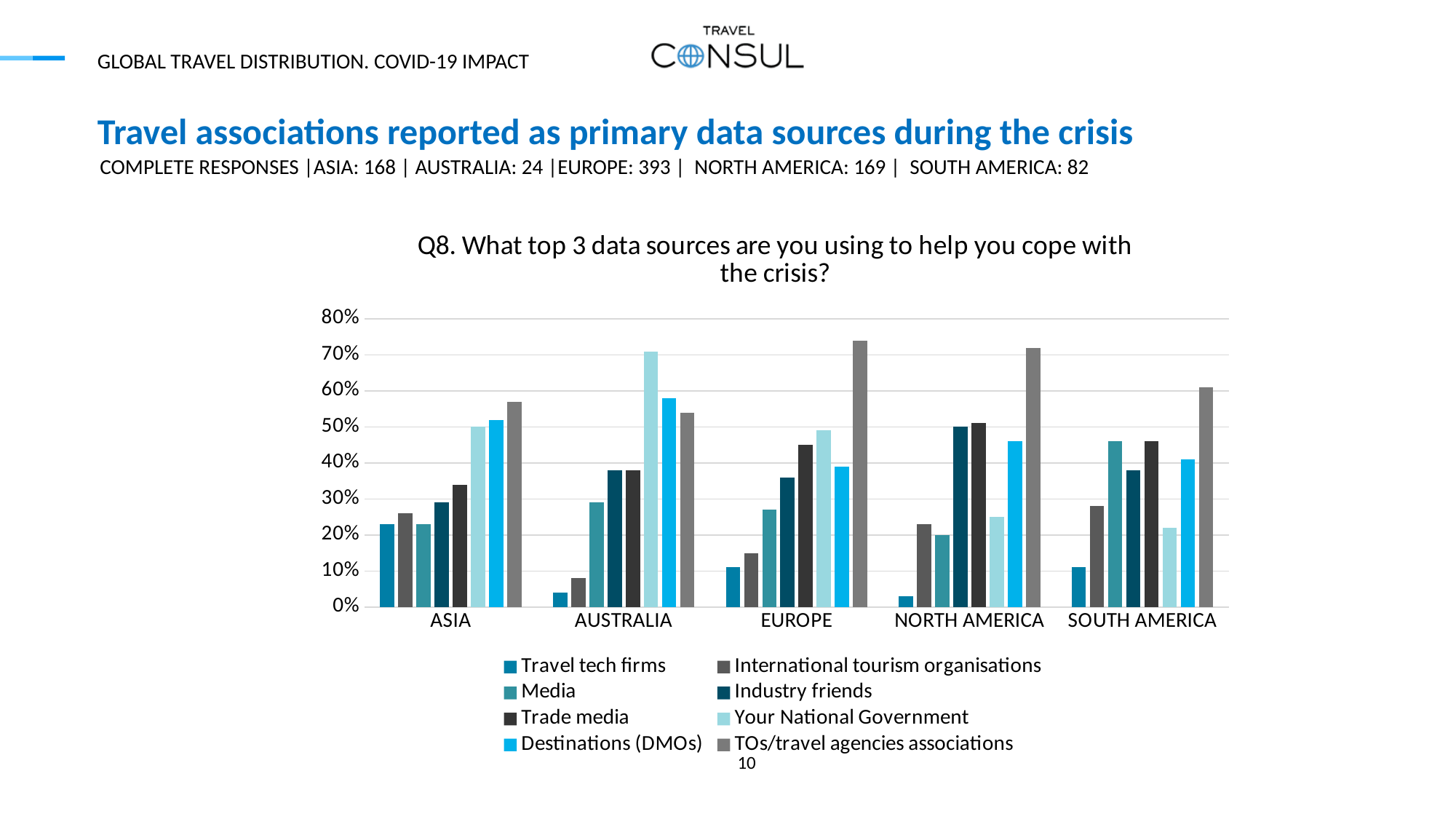
Is the value for TOs/travel agencies associations in North America greater or less than 60%? greater Which data source has the highest value for Europe? TOs/travel agencies associations What is the title of the chart? Q8. What top 3 data sources are you using to help you cope with the crisis? For Asia, which is larger: Your National Government or Trade media? Your National Government How many data sources (series) does the chart legend list? 8 Which data source has the highest value for Australia? Your National Government Which data source has the lowest value for North America? Travel tech firms How many regions are shown along the x axis of the chart? 5 Is the value for Your National Government in Australia greater or less than 60%? greater For South America, which is larger: Media or Industry friends? Media Is the value for Travel tech firms in Europe greater or less than 20%? less What kind of chart is shown on the slide? Bar chart